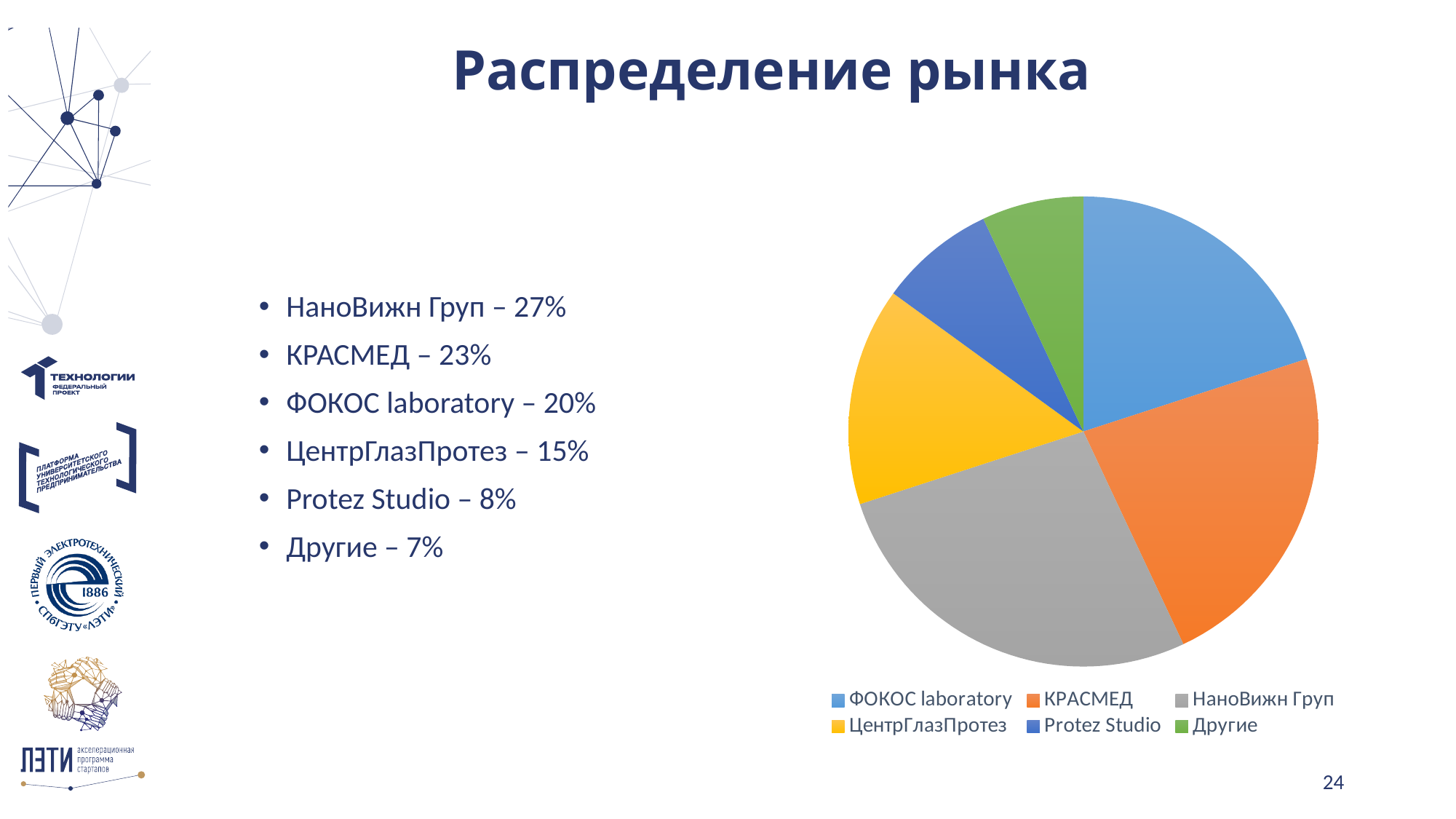
Which has a larger share, КРАСМЕД or ФОКОС laboratory? КРАСМЕД How many slices does the pie chart have? 6 How many entries does the legend of the pie chart list? 6 What is the difference between the shares of НаноВижн Груп and ЦентрГлазПротез? 12% What colour is the ЦентрГлазПротез slice in the pie chart? yellow What kind of chart is shown on the slide? pie chart Which slice of the pie chart is the smallest? Другие What share of the market does ФОКОС laboratory hold according to the slide? 20% What share of the market does КРАСМЕД hold according to the slide? 23% Which slice of the pie chart is the largest? НаноВижн Груп What share of the market does НаноВижн Груп hold according to the slide? 27%